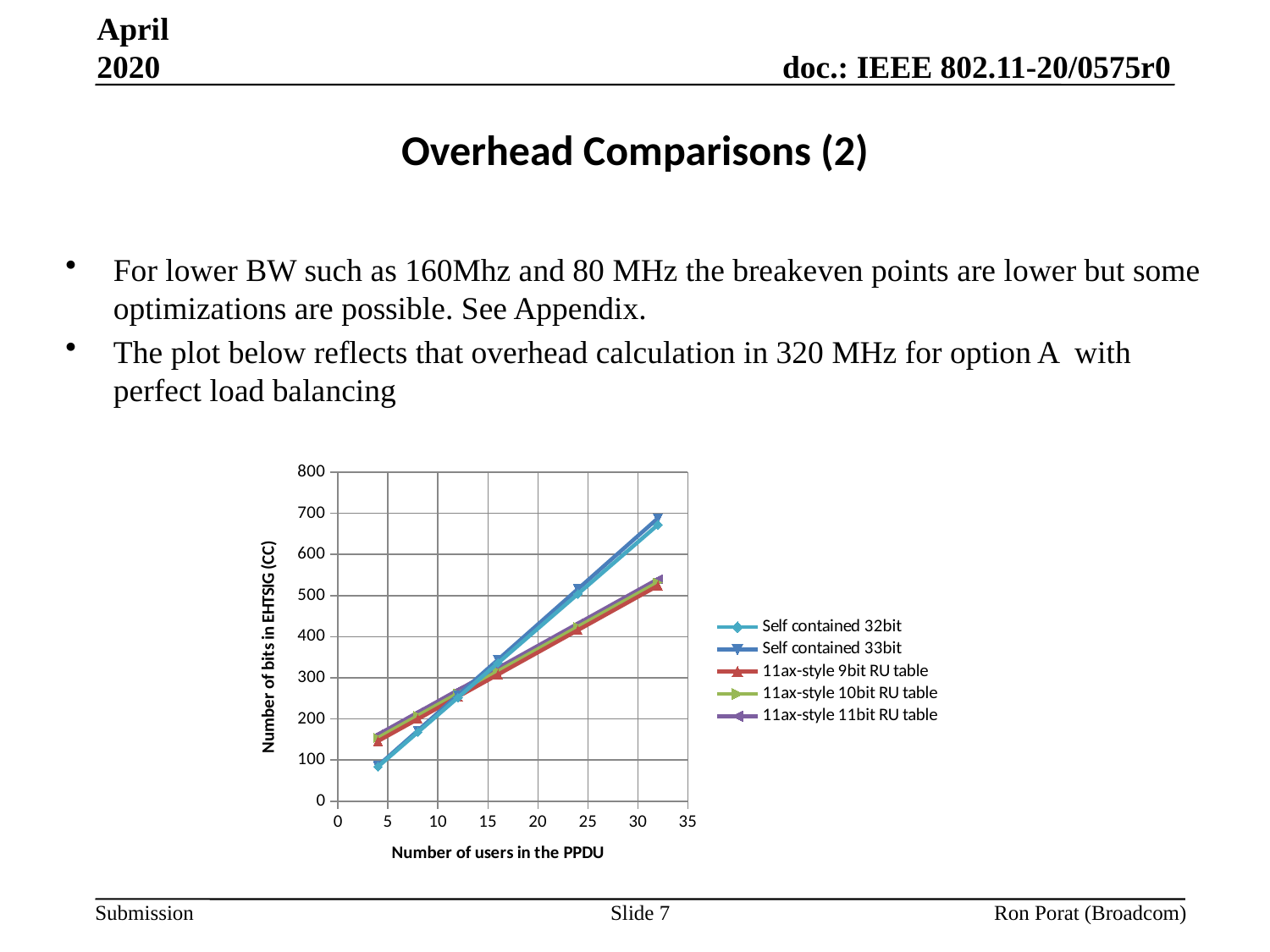
What is the label of the vertical axis? Number of bits in EHTSIG (CC) Is the value for Self contained 33bit at 32 users greater or less than 600? greater At 4 users, which is larger: 11ax-style 11bit RU table or Self contained 32bit? 11ax-style 11bit RU table How many series does the chart legend list? 5 At 32 users, which is larger: Self contained 33bit or 11ax-style 9bit RU table? Self contained 33bit Is the value for 11ax-style 11bit RU table at 4 users greater or less than 100? greater What is the label of the horizontal axis? Number of users in the PPDU Do the values for Self contained 33bit rise or fall as the number of users in the PPDU increases? rise Is the value for 11ax-style 9bit RU table at 32 users greater or less than 600? less How many data points are plotted for each series? 6 What kind of chart is shown on the slide? line chart